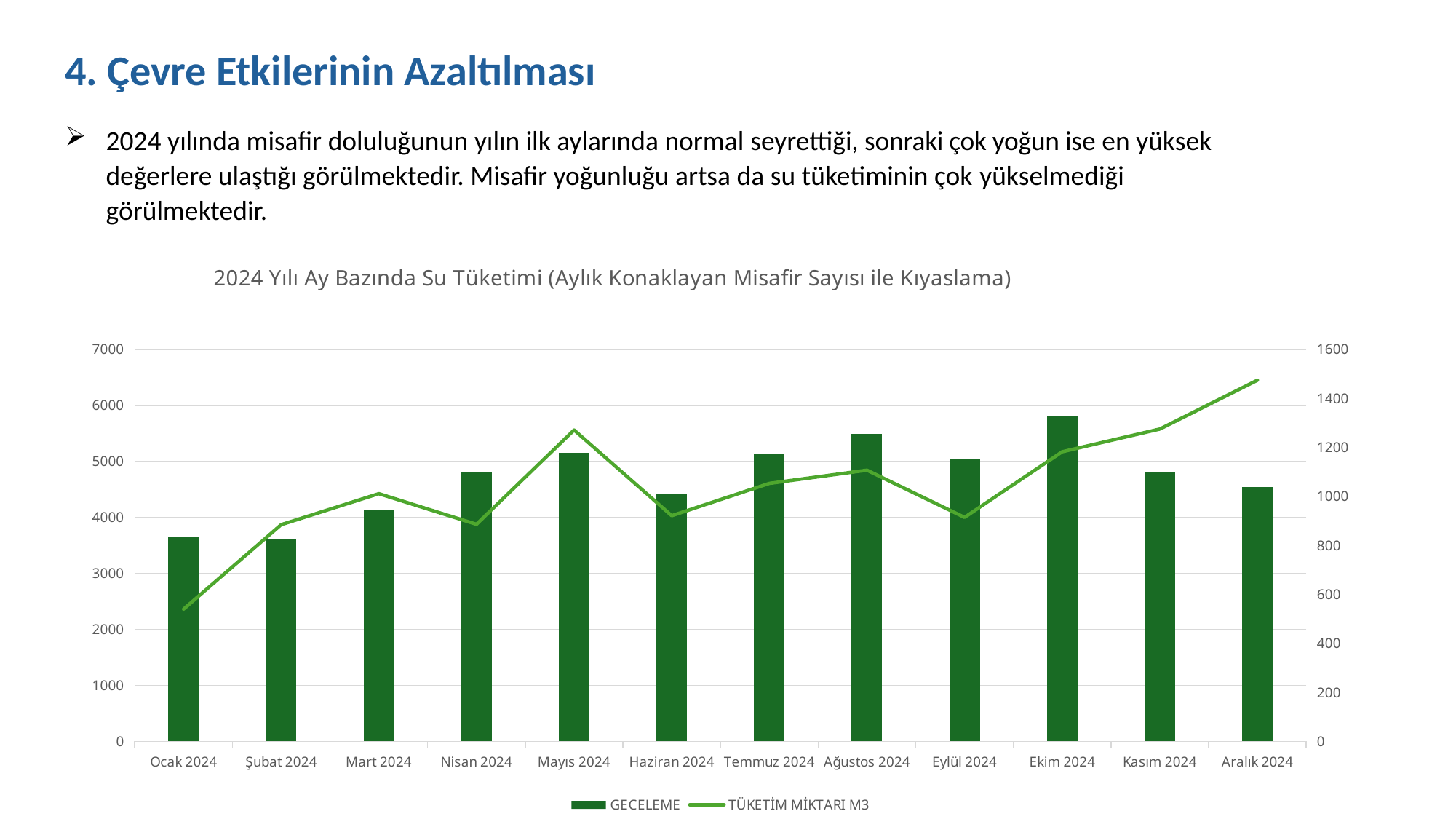
Is the GECELEME value for Ekim 2024 greater or less than 5000 on the left axis? greater Which month has the larger GECELEME bar, Ağustos 2024 or Haziran 2024? Ağustos 2024 In which month does the TÜKETİM MİKTARI M3 line reach its highest point? Aralık 2024 In which month is the TÜKETİM MİKTARI M3 line at its lowest point? Ocak 2024 Which month has the highest GECELEME bar? Ekim 2024 Which month has the higher TÜKETİM MİKTARI M3 value, Mayıs 2024 or Haziran 2024? Mayıs 2024 How many series does the chart legend list? 2 What is the title of the chart? 2024 Yılı Ay Bazında Su Tüketimi (Aylık Konaklayan Misafir Sayısı ile Kıyaslama) How many months are shown on the x axis of the chart? 12 What kind of chart is shown on the slide? A combined bar and line chart Is the TÜKETİM MİKTARI M3 value for Ocak 2024 greater or less than 600 on the right axis? less Is the GECELEME value for Haziran 2024 greater or less than 5000 on the left axis? less